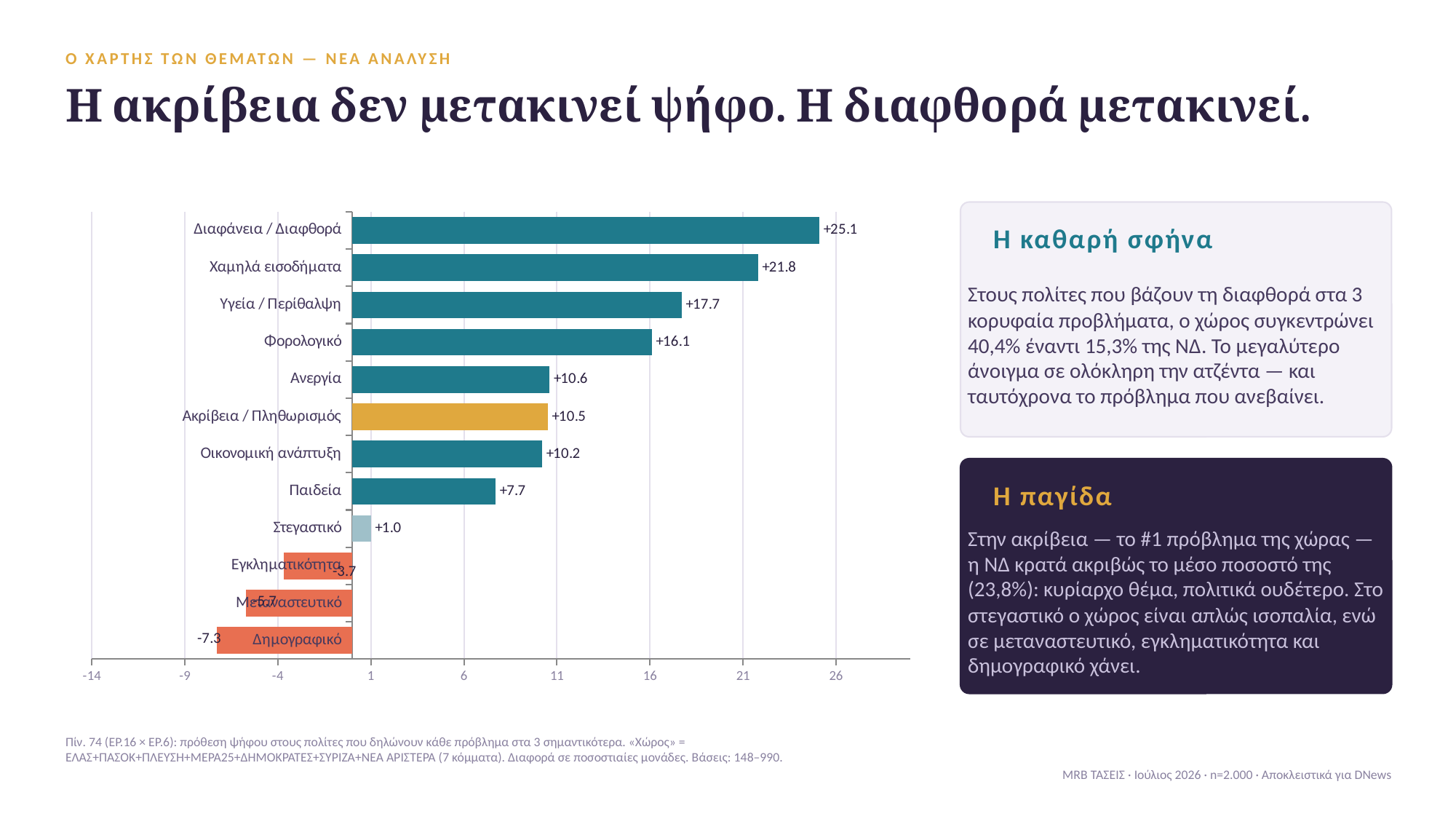
Which is larger, the value for Υγεία / Περίθαλψη or the value for Φορολογικό? Υγεία / Περίθαλψη What is the value for Δημογραφικό? -7.3 How many categories are shown in the chart? 12 What is the value for Ακρίβεια / Πληθωρισμός? +10.5 What is the value for Στεγαστικό? +1.0 Which category's bar is coloured yellow/orange rather than teal? Ακρίβεια / Πληθωρισμός Which category has the lowest value? Δημογραφικό What kind of chart is shown on the slide? Bar chart What is the value for Διαφάνεια / Διαφθορά? +25.1 What is the difference between the values for Διαφάνεια / Διαφθορά and Χαμηλά εισοδήματα? 3.3 Which category has the highest value? Διαφάνεια / Διαφθορά Is the value for Παιδεία greater or less than 6? greater